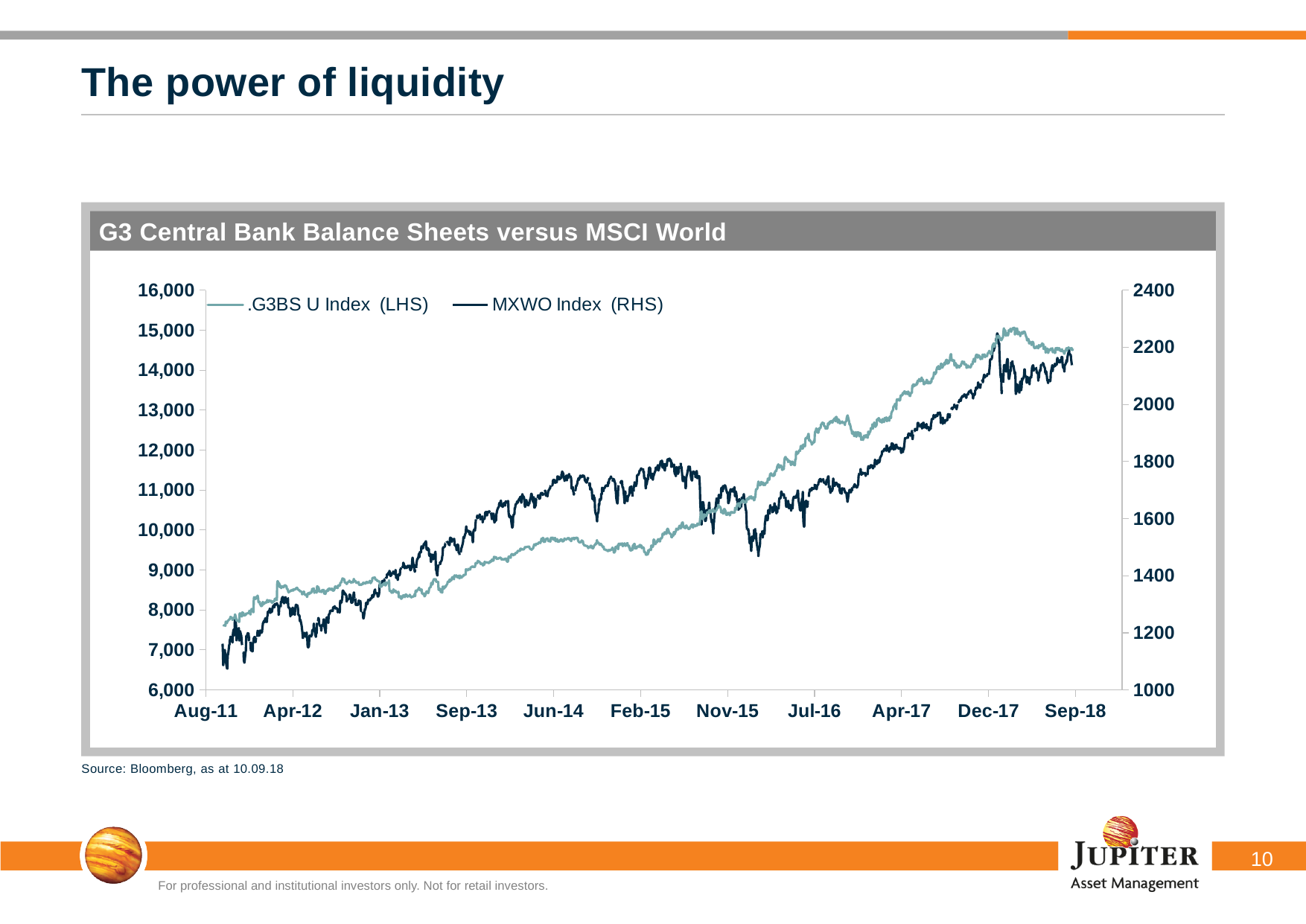
Is the value of the .G3BS U Index at Aug-11 greater or less than 8,000? less Is the value of the MXWO Index at Aug-11 greater or less than 1200? less Does the .G3BS U Index rise or fall overall from Aug-11 to Sep-18? Rise Is the value of the .G3BS U Index at Sep-18 greater or less than 14,000? greater How many date labels are shown on the x axis? 11 Does the MXWO Index rise or fall overall from Aug-11 to Sep-18? Rise Which series is plotted against the right-hand axis (RHS)? MXWO Index What kind of chart is shown on the slide? Line chart What is the title of the chart? G3 Central Bank Balance Sheets versus MSCI World How many series does the legend list? 2